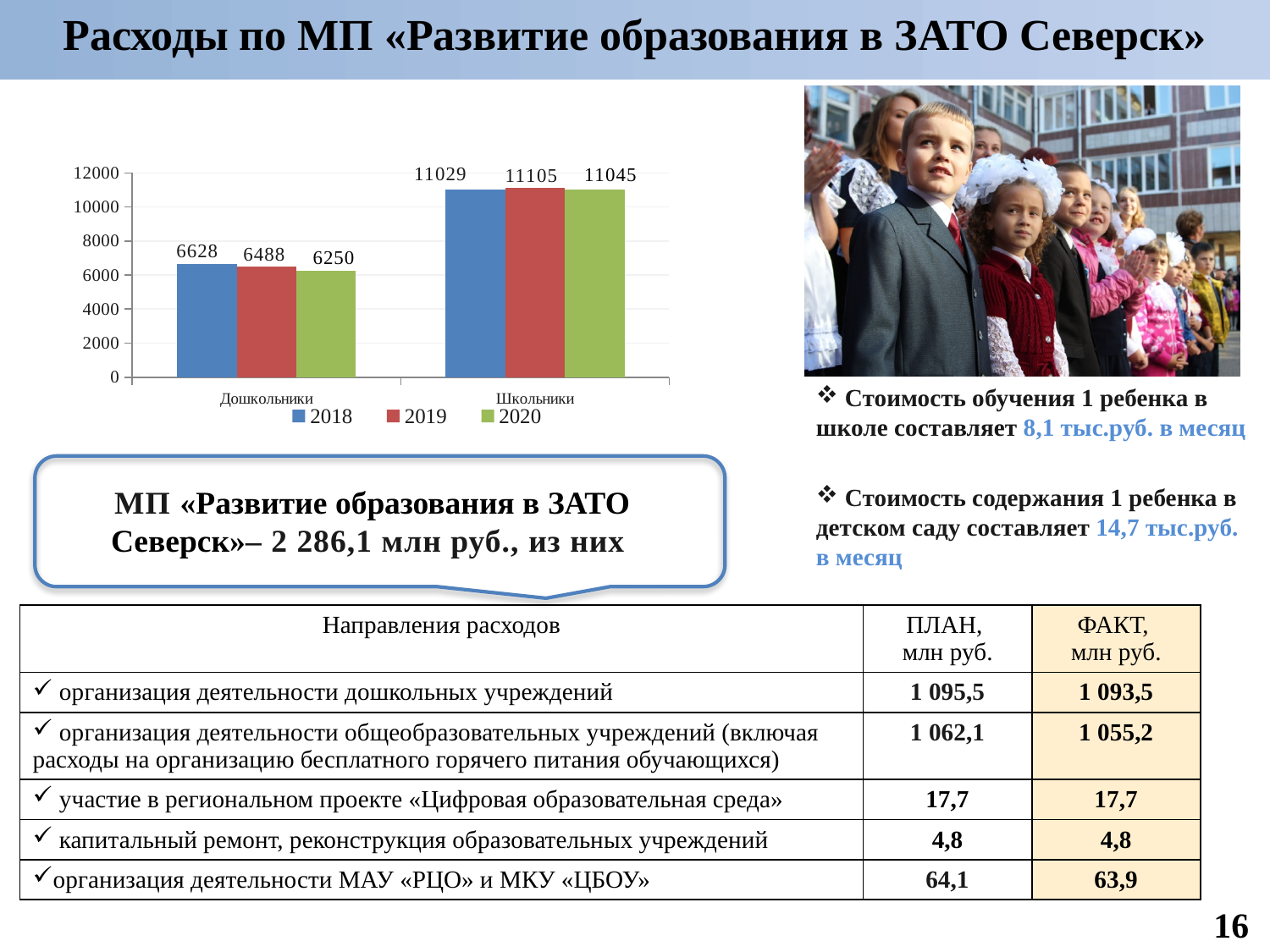
Do the values for Дошкольники rise or fall from 2018 to 2020? fall Which year has the highest value for Школьники? 2019 Which is larger: the 2019 value for Школьники or the 2019 value for Дошкольники? Школьники What kind of chart is shown on the slide? bar chart How many series does the legend list? 3 What is the difference between the 2018 and 2020 values for Дошкольники? 378 What is the value for Школьники in 2020? 11045 Is the value for Школьники in 2018 greater or less than 10000? greater Which year has the lowest value for Дошкольники? 2020 What is the value for Дошкольники in 2020? 6250 How many categories are shown on the x axis? 2 What is the value for Дошкольники in 2018? 6628